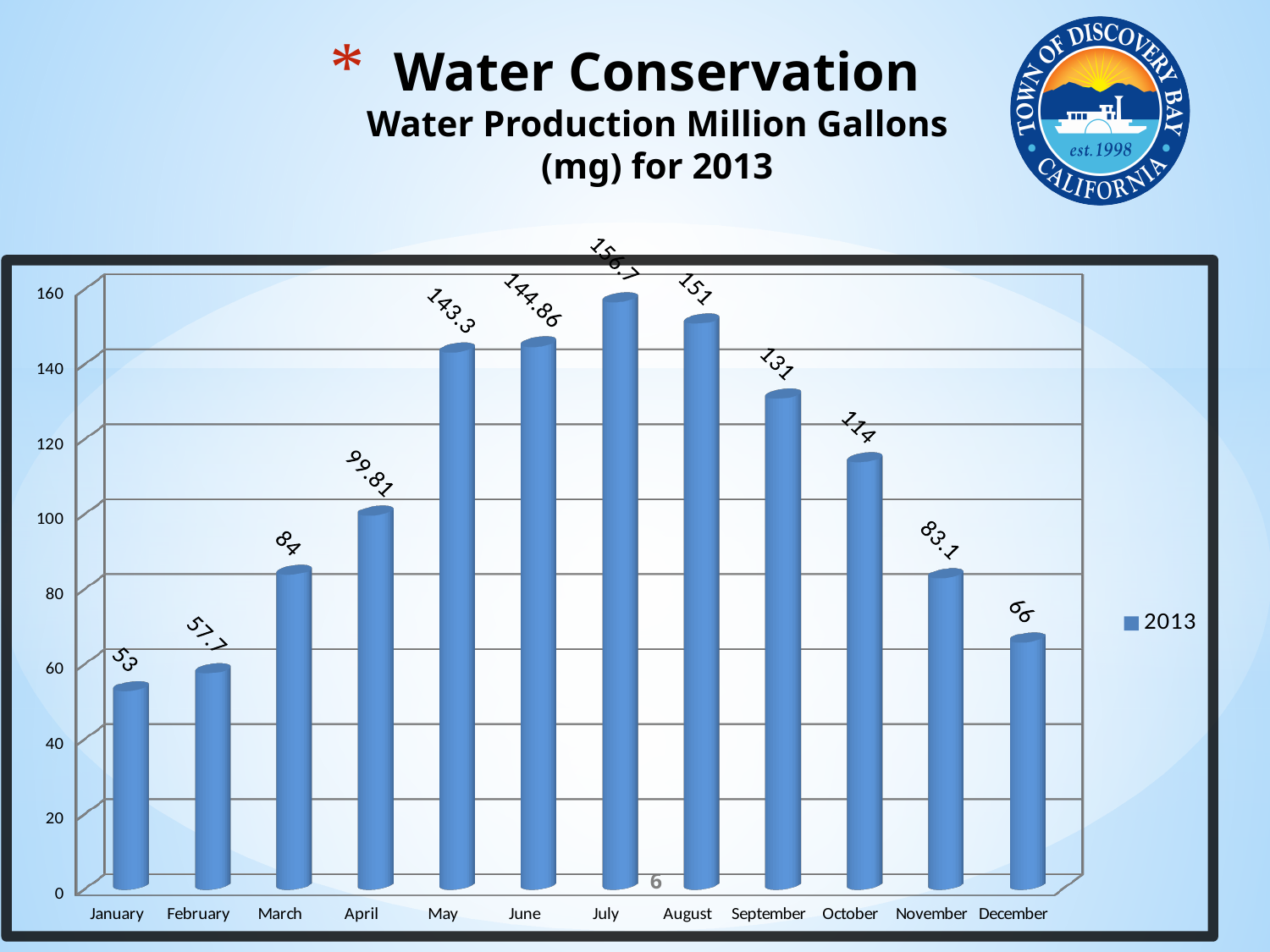
What is the difference between the values for February and January? 4.7 Which is larger, the value for May or the value for June? June Which month has the highest water production? July How many series does the legend list? 1 What is the difference between the values for August and September? 20 What kind of chart is shown on the slide? bar chart Which month has the lowest water production? January What is the water production value for November? 83.1 What is the water production value for April? 99.81 What is the water production value for July? 156.7 How many months are shown on the x axis? 12 Is the value for October greater or less than 100? greater